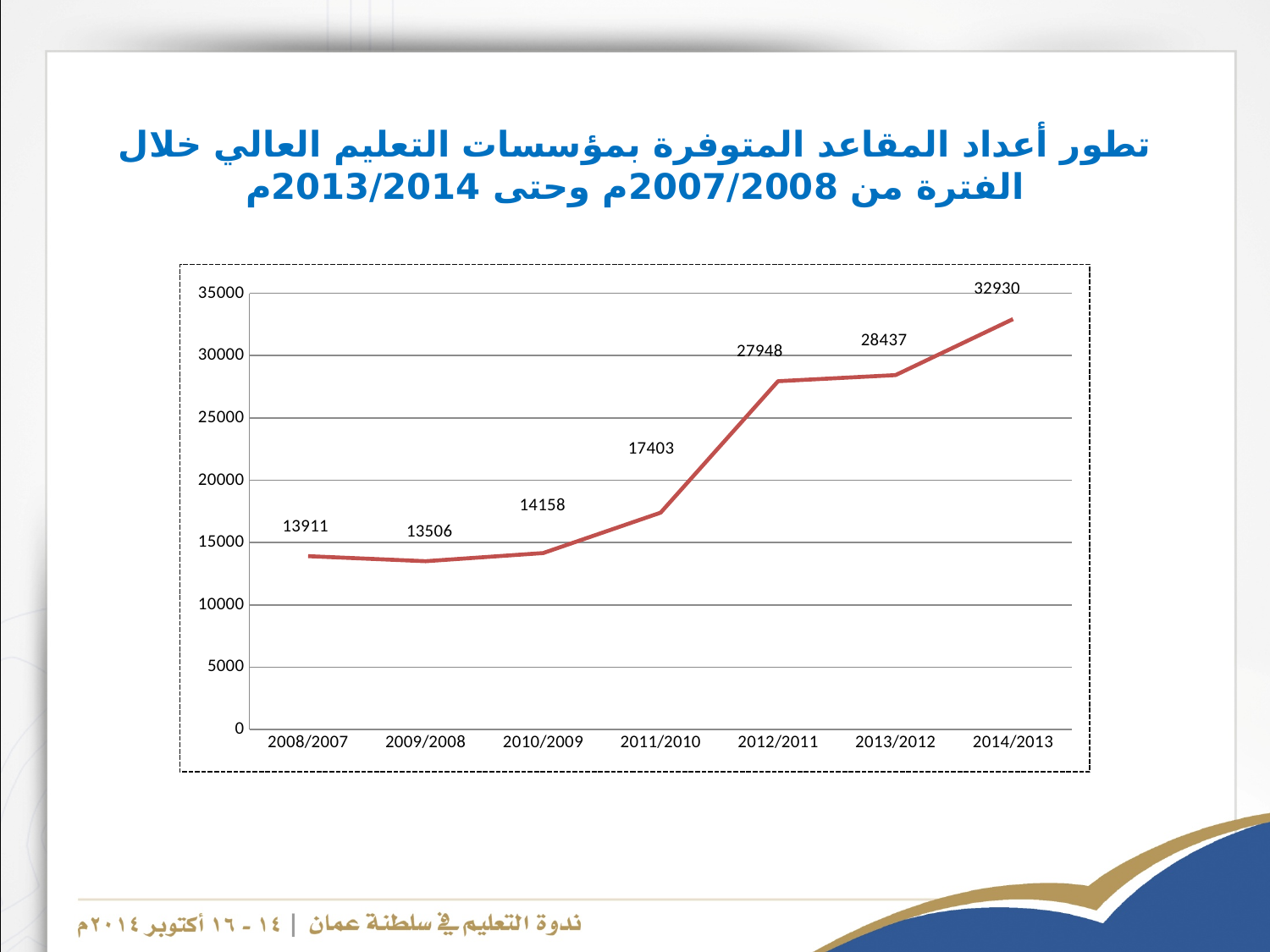
Is the value for 2010/2009 greater or less than 15000? less How many years are plotted on the x axis? 7 What is the difference between the values for 2014/2013 and 2008/2007? 19019 What kind of chart is shown on the slide? line chart What is the value for 2011/2010? 17403 Which is larger, the value for 2013/2012 or the value for 2012/2011? 2013/2012 What is the value for 2014/2013? 32930 Which year has the lowest value? 2009/2008 What is the value for 2008/2007? 13911 Which year has the highest value? 2014/2013 What is the difference between the values for 2012/2011 and 2011/2010? 10545 Do the values generally rise or fall from 2008/2007 to 2014/2013? rise